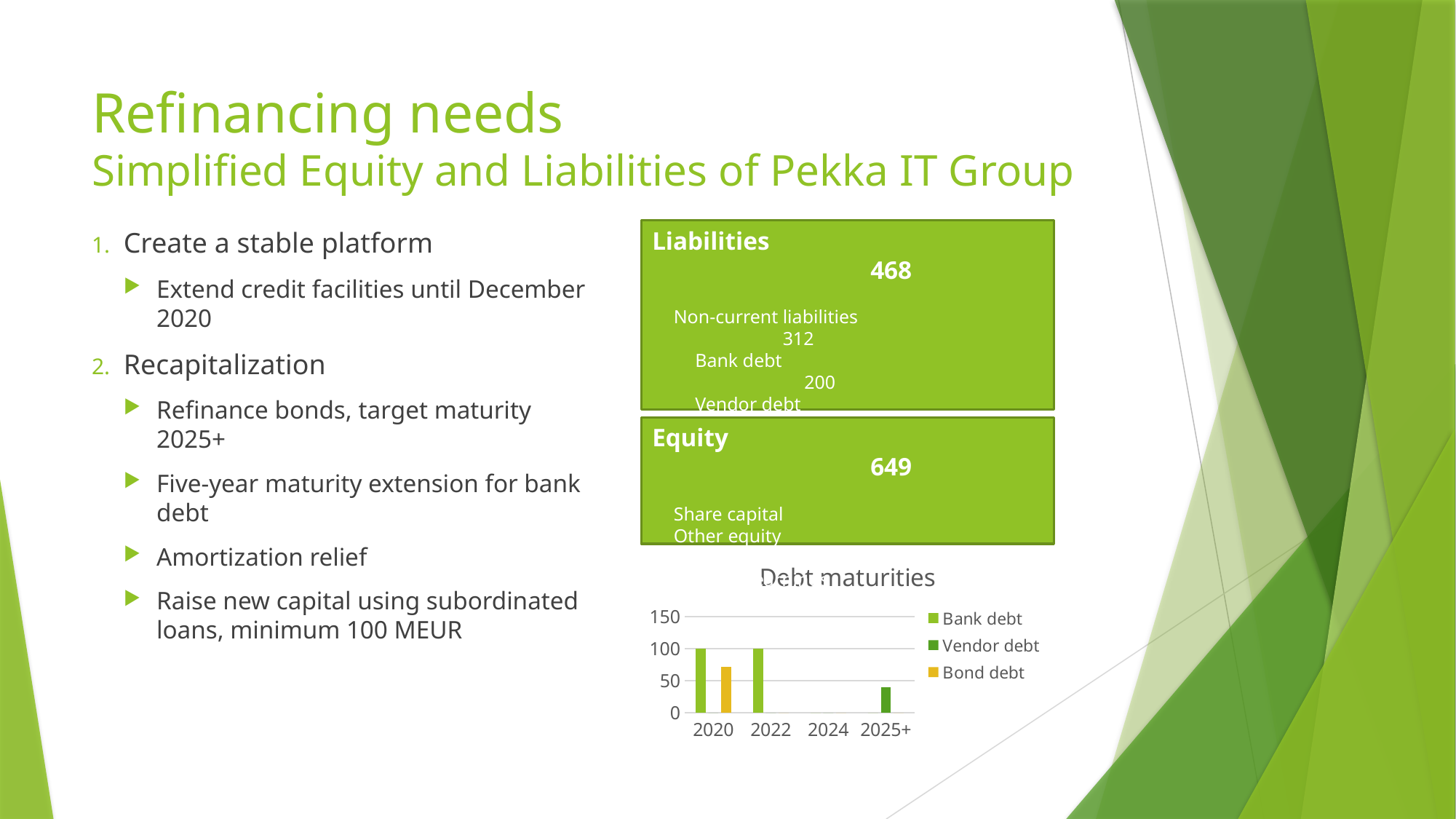
In the Debt maturities chart, which series has the smallest bar? Vendor debt In the Debt maturities chart, which is larger: Bond debt in 2020 or Vendor debt in 2025+? Bond debt in 2020 What is the title of the chart at the bottom right of the slide? Debt maturities How many categories are shown on the x axis of the Debt maturities chart? 4 In the Debt maturities chart, what is the value for Bank debt in 2020? 100 How many series does the legend of the Debt maturities chart list? 3 In the Debt maturities chart, which year on the x axis has no bars plotted? 2024 In the Debt maturities chart, is the value for Bank debt in 2022 greater or less than 50? greater In the Debt maturities chart, is the value for Vendor debt in 2025+ greater or less than 50? less In the Debt maturities chart, is the value for Bond debt in 2020 greater or less than 50? greater What kind of chart is the Debt maturities chart? bar chart In the Debt maturities chart, which is larger in 2020: Bank debt or Bond debt? Bank debt